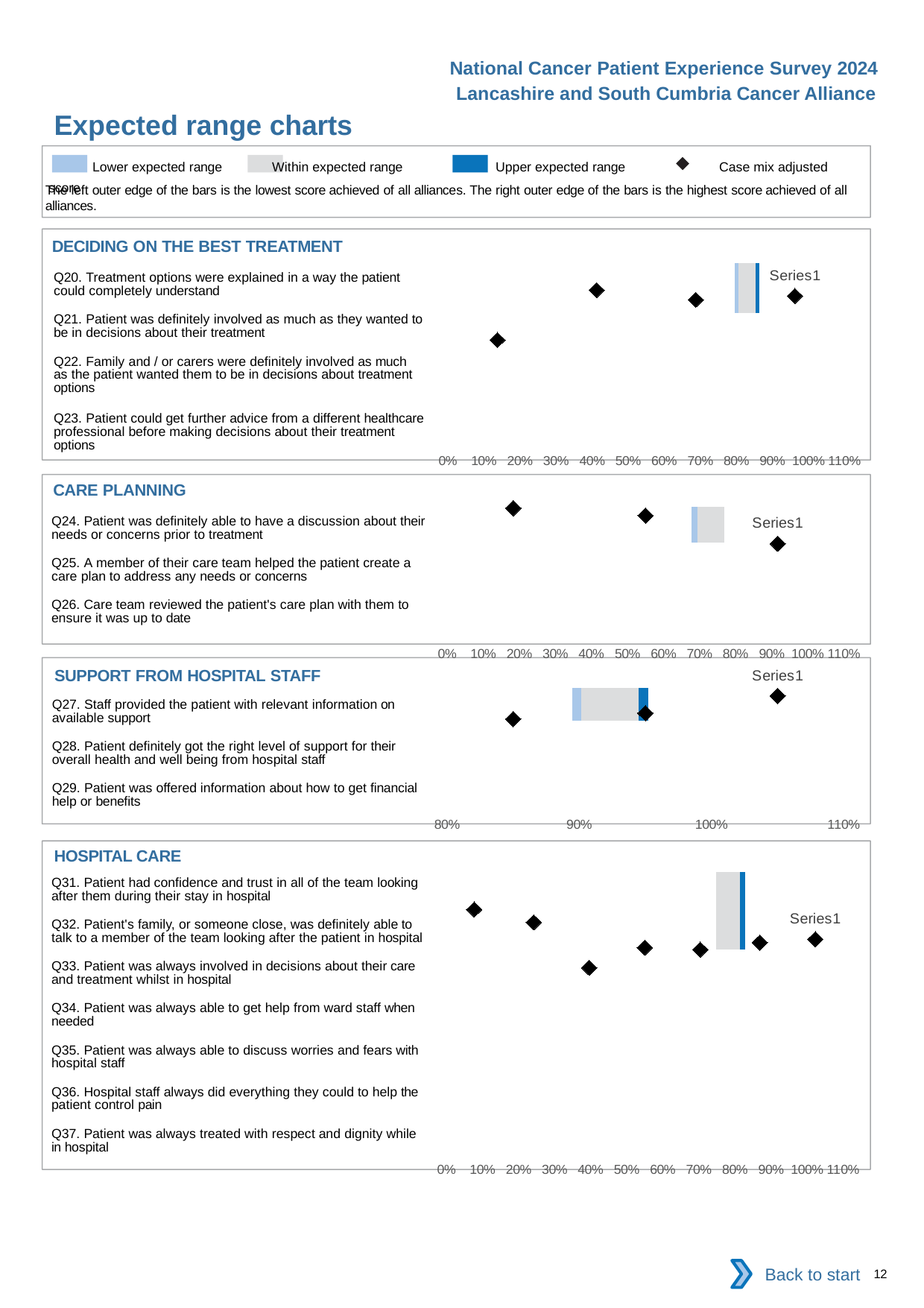
In the HOSPITAL CARE chart, what is the highest value shown on the x axis? 110% What is the title of the last chart on the slide? HOSPITAL CARE In the DECIDING ON THE BEST TREATMENT chart, how many case mix adjusted score markers (diamonds) are plotted? 4 How many entries does the legend at the top of the slide list? 4 In the DECIDING ON THE BEST TREATMENT chart, how many questions (categories) are listed? 4 What is the title of the first chart on the slide? DECIDING ON THE BEST TREATMENT In the SUPPORT FROM HOSPITAL STAFF chart, how many questions (categories) are listed? 3 In the SUPPORT FROM HOSPITAL STAFF chart, what is the lowest value shown on the x axis? 80%